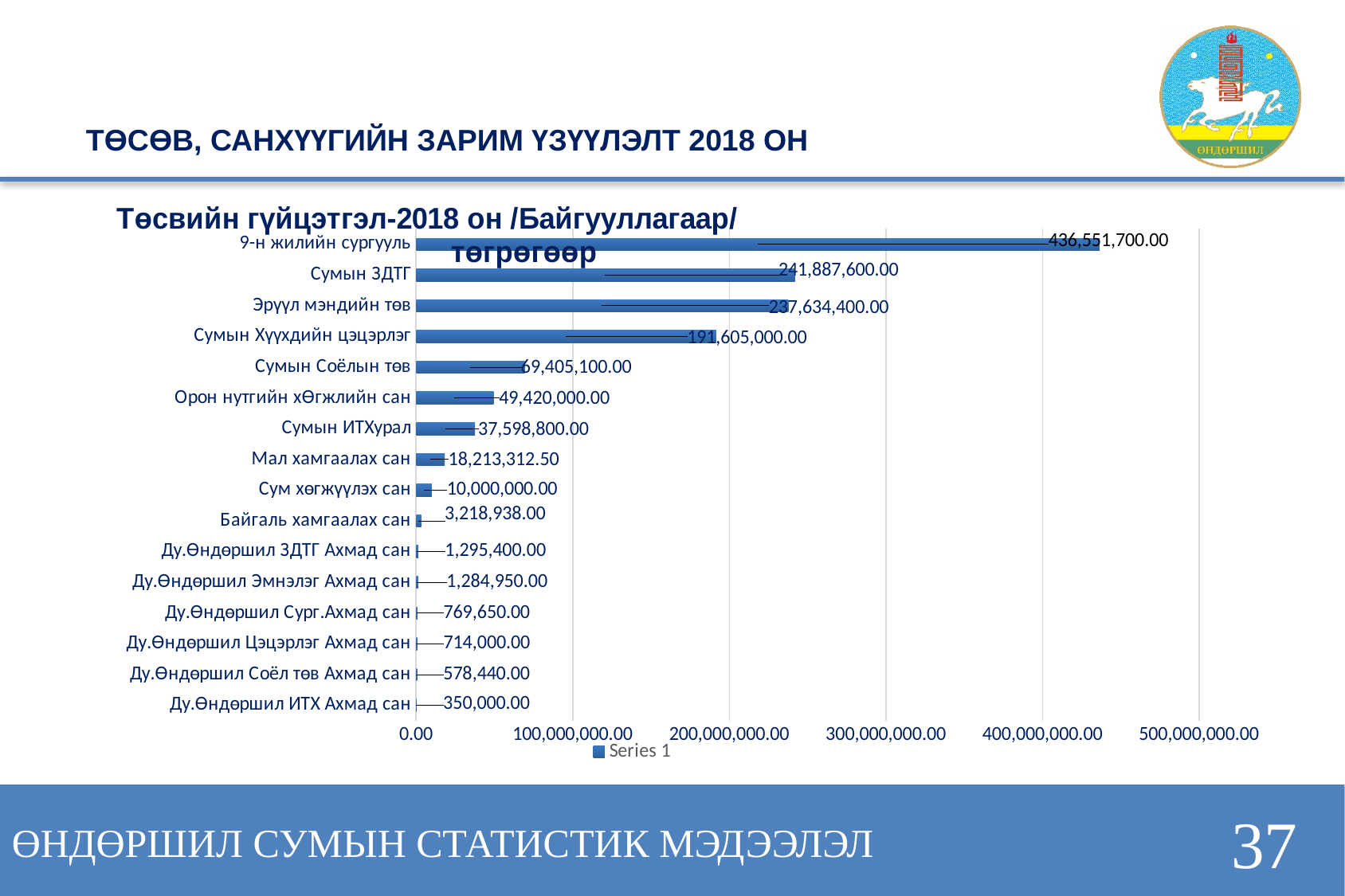
What is the value for Мал хамгаалах сан? 18,213,312.50 What is the value for Сумын Соёлын төв? 69,405,100.00 How many categories are shown in the chart? 16 Is the value for Сумын ЗДТГ greater or less than 200,000,000.00? greater Which category has the lowest value? Ду.Өндөршил ИТХ Ахмад сан What is the value for 9-н жилийн сургууль? 436,551,700.00 Which category has the highest value? 9-н жилийн сургууль What is the difference between the values for 9-н жилийн сургууль and Сумын ЗДТГ? 194,664,100.00 How many series does the legend list? 1 Which is larger, the value for Сумын Хүүхдийн цэцэрлэг or the value for Сумын ИТХурал? Сумын Хүүхдийн цэцэрлэг What kind of chart is shown on the slide? bar chart What is the difference between the values for Сумын Соёлын төв and Орон нутгийн хӨгжлийн сан? 19,985,100.00